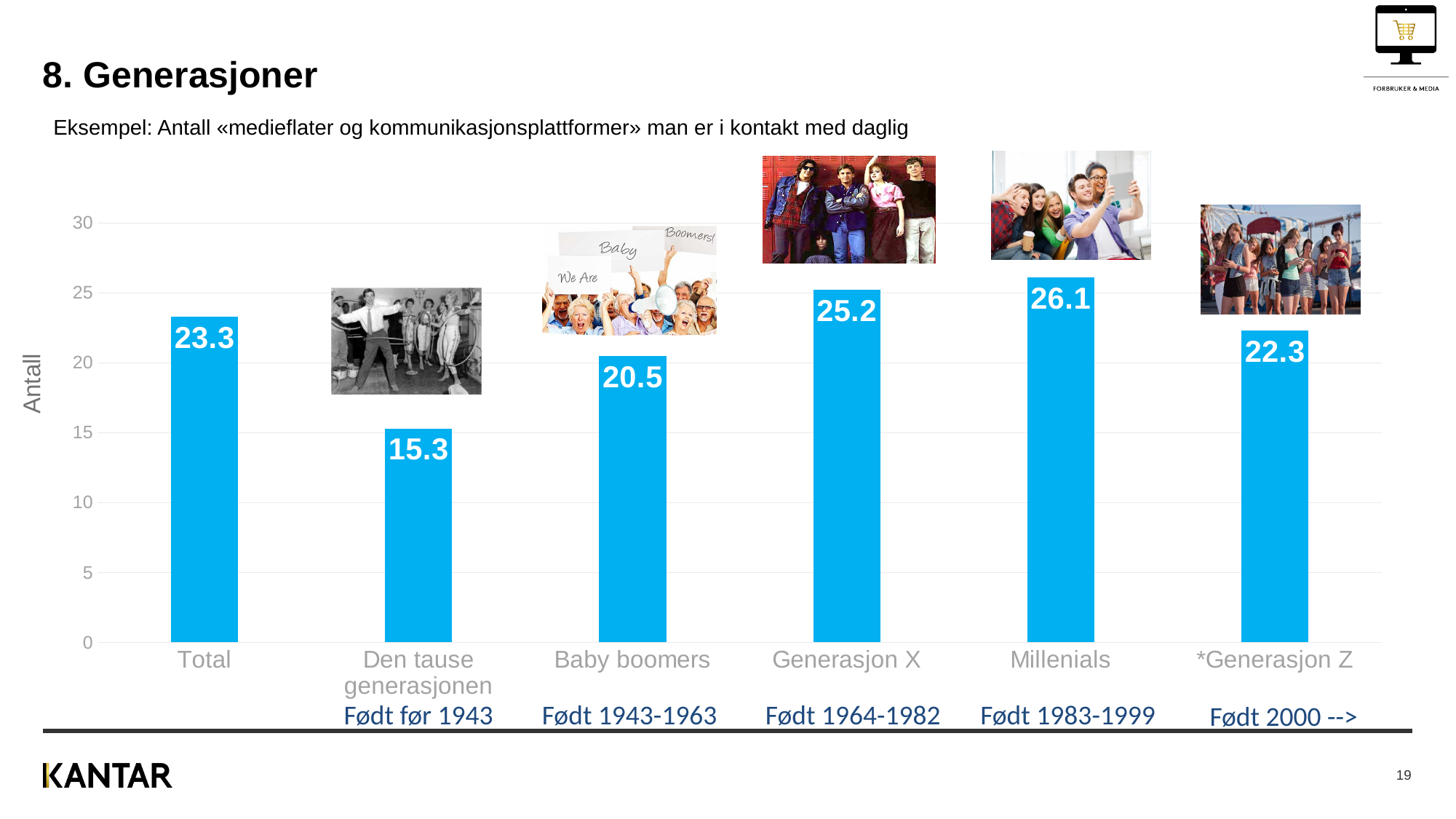
What is the value for Den tause generasjonen? 15.3 What kind of chart is shown on the slide? Bar chart What is the label of the y axis? Antall What is the value for Baby boomers? 20.5 How many categories are shown on the x axis? 6 What is the value for Total? 23.3 What is the value for Generasjon X? 25.2 What is the difference between the values for Millenials and Den tause generasjonen? 10.8 Which category has the lowest value? Den tause generasjonen Which category has the highest value? Millenials What is the value for *Generasjon Z? 22.3 Which is larger, the value for Generasjon X or the value for *Generasjon Z? Generasjon X